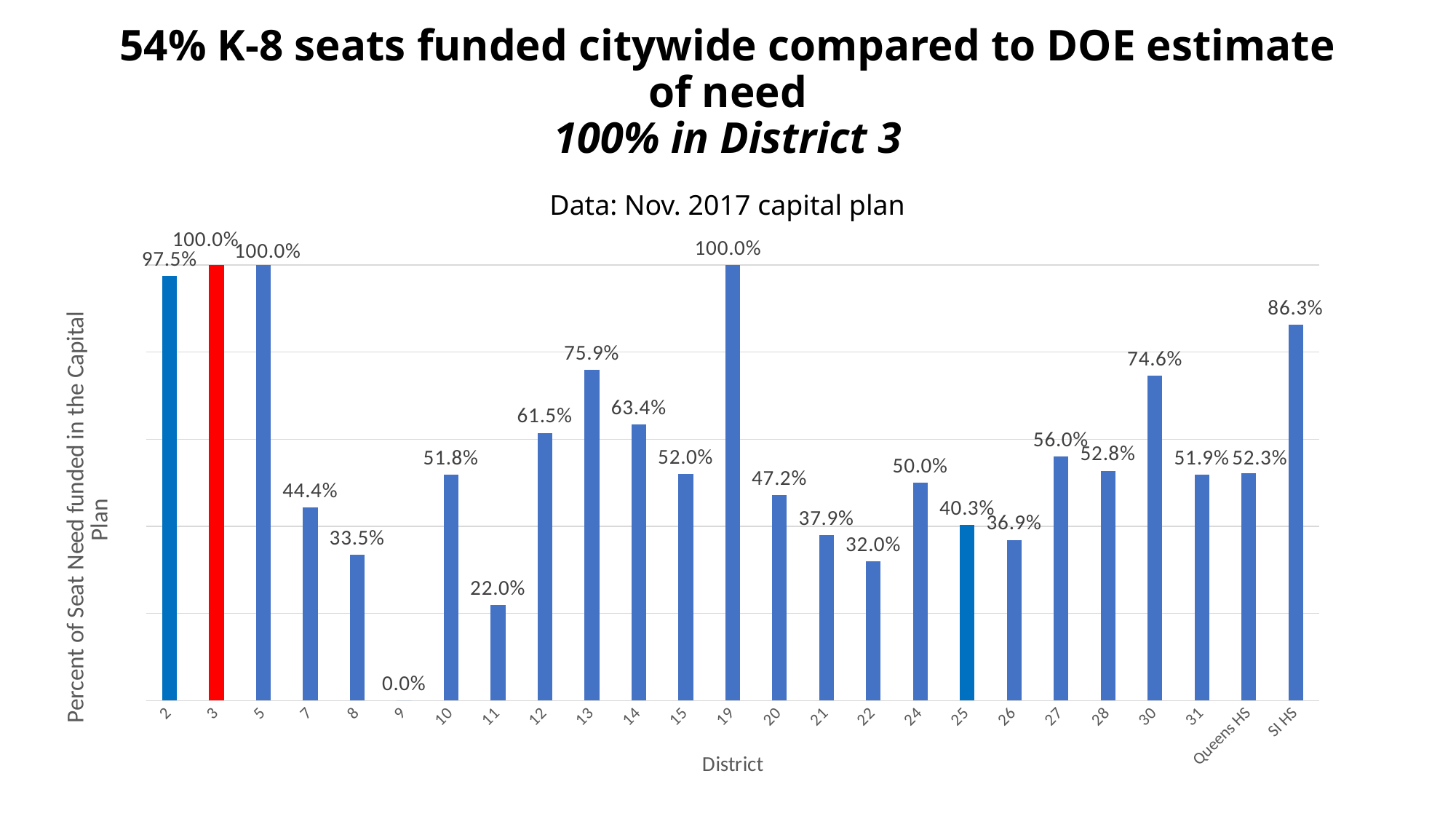
What is the value for SI HS? 86.3% What kind of chart is shown on the slide? Bar chart How many districts or categories are shown on the x axis? 25 What is the value for District 11? 22.0% Which district has the lowest percent of seat need funded? District 9 What is the value for District 3? 100.0% What is the value for District 13? 75.9% Which district's bar is coloured red? District 3 What is the value for Queens HS? 52.3% What is the difference between the values for District 13 and District 30? 1.3 percentage points What is the difference between the values for District 3 and District 2? 2.5 percentage points Which has a higher value, District 12 or District 14? District 14